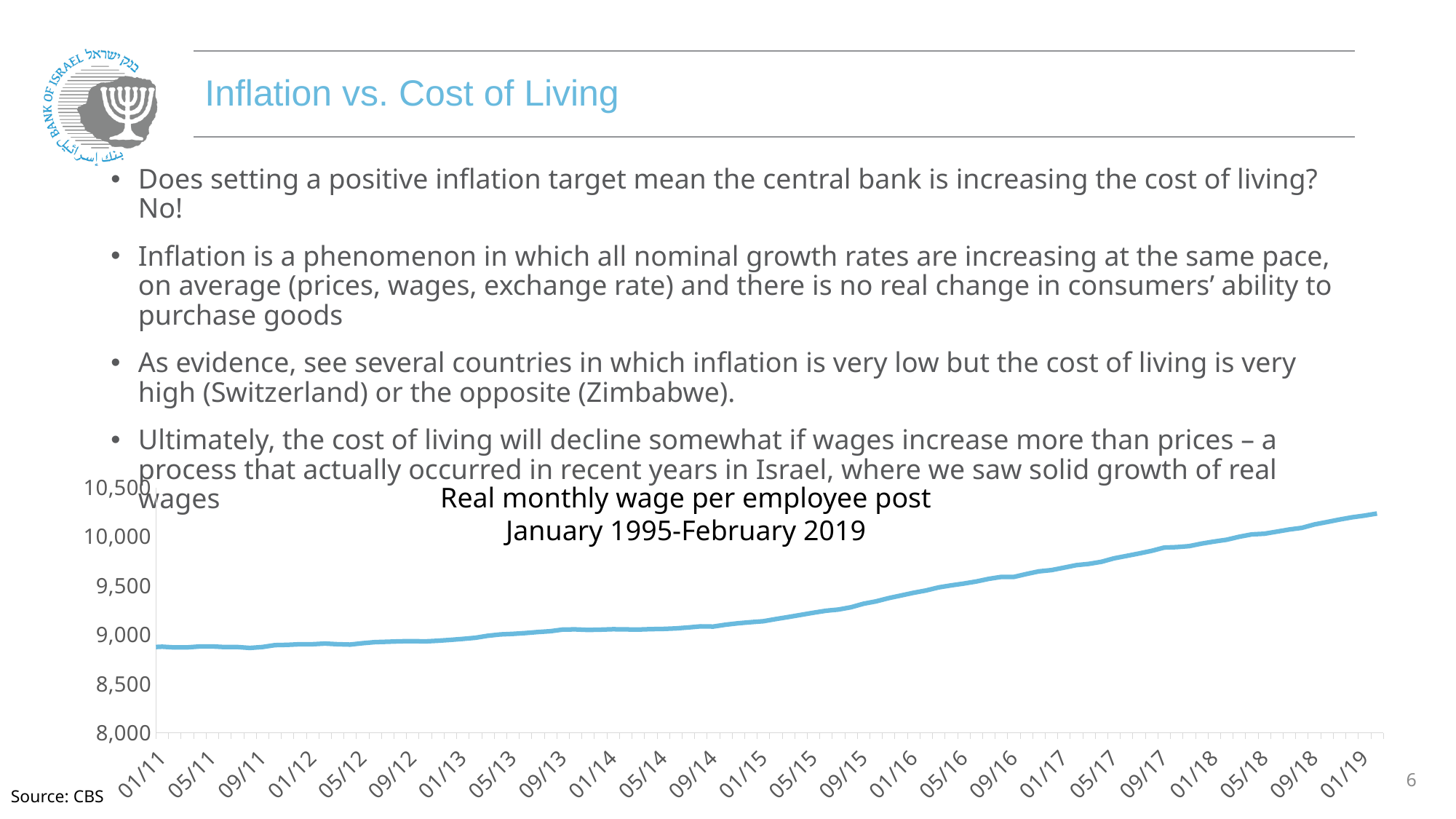
Is the value for 01/11 greater or less than 9,000? less What kind of chart is shown on the slide? Line chart At which labelled date on the x axis does the line reach its highest value? 01/19 What is the source cited for the chart? CBS Which of the two dates has the larger value, 01/12 or 01/18? 01/18 Do the values in the chart generally rise or fall from left to right along the x axis? Rise Is the value for 09/17 greater or less than 10,000? less Is the value for 01/15 greater or less than 9,000? greater What is the title of the chart? Real monthly wage per employee post January 1995-February 2019